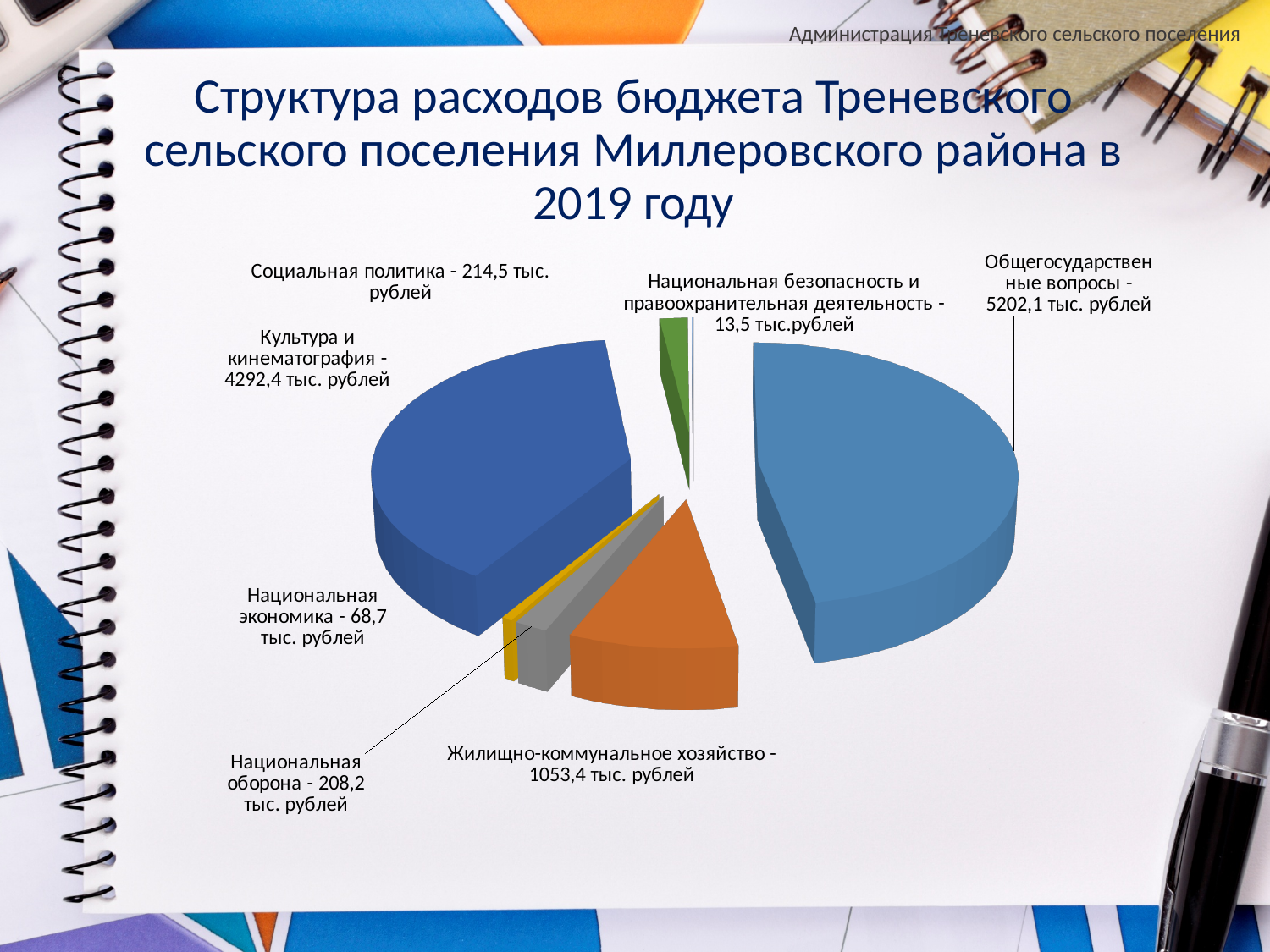
What is the difference between Общегосударственные вопросы and Культура и кинематография? 909,7 тыс. рублей What year does the chart title refer to? 2019 What is the value for Общегосударственные вопросы? 5202,1 тыс. рублей How many categories does the pie chart show? 7 Which category has the smallest expenditure? Национальная безопасность и правоохранительная деятельность What is the value for Культура и кинематография? 4292,4 тыс. рублей Which is larger: Социальная политика or Национальная экономика? Социальная политика What type of chart is shown on the slide? pie chart What is the value for Национальная безопасность и правоохранительная деятельность? 13,5 тыс.рублей What is the value for Национальная оборона? 208,2 тыс. рублей Which category has the largest expenditure? Общегосударственные вопросы What is the value for Жилищно-коммунальное хозяйство? 1053,4 тыс. рублей